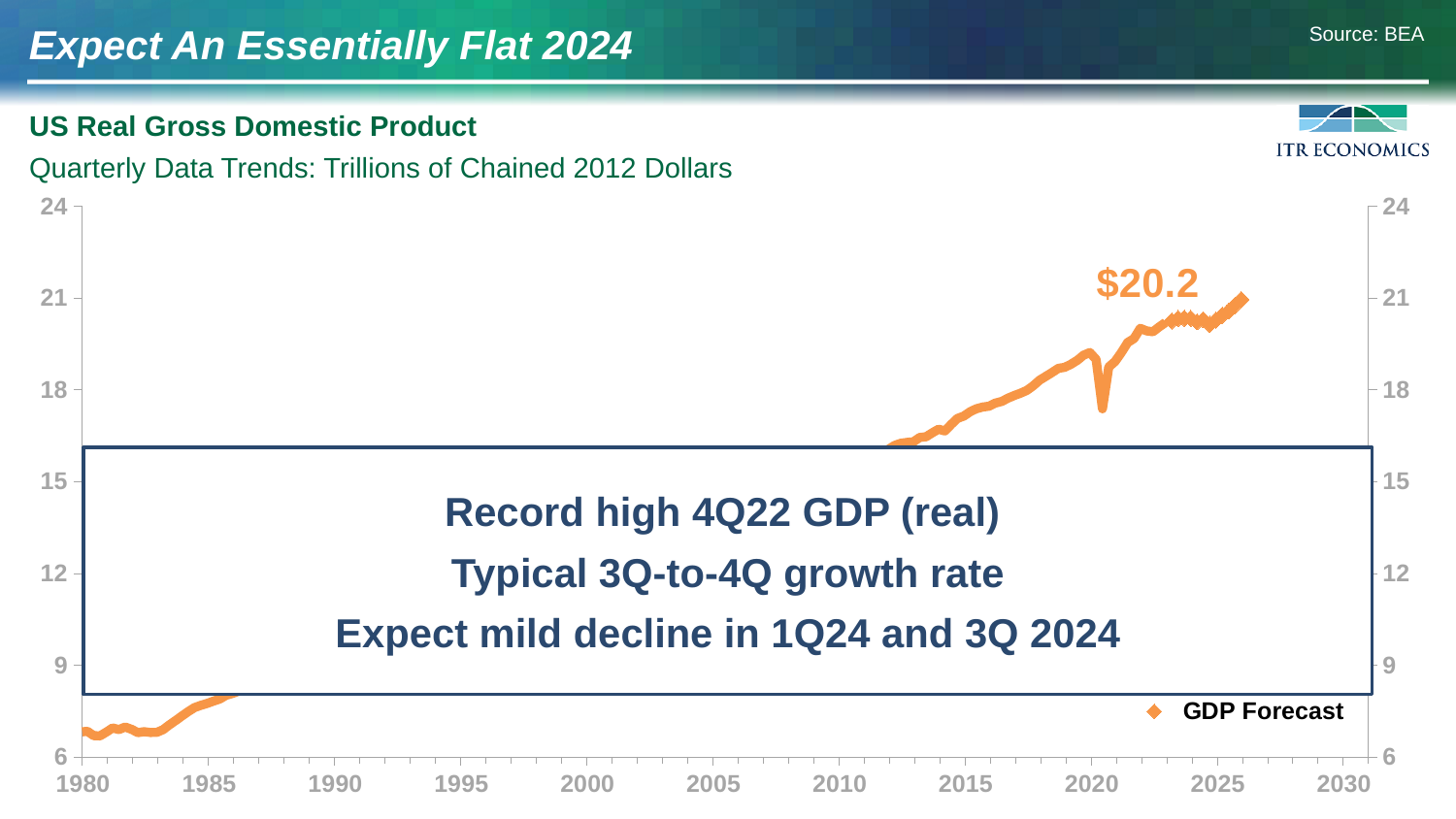
What is the title of the chart? US Real Gross Domestic Product What value is printed as a data label near the end of the plotted series? $20.2 In what units is the chart's data expressed, according to the subtitle? Trillions of Chained 2012 Dollars Overall, do the values rise or fall from 1980 to 2025? rise How many series does the legend list? 1 Is the value for 2019 greater or less than 18? greater Which is larger, the value for 2015 or the value for 2025? 2025 Is the value for 1985 greater or less than 12? less What kind of chart is shown on the slide? line chart Is the value for 2025 greater or less than 18? greater Is the value at the end of the series higher or lower than the value at the start of the series? higher